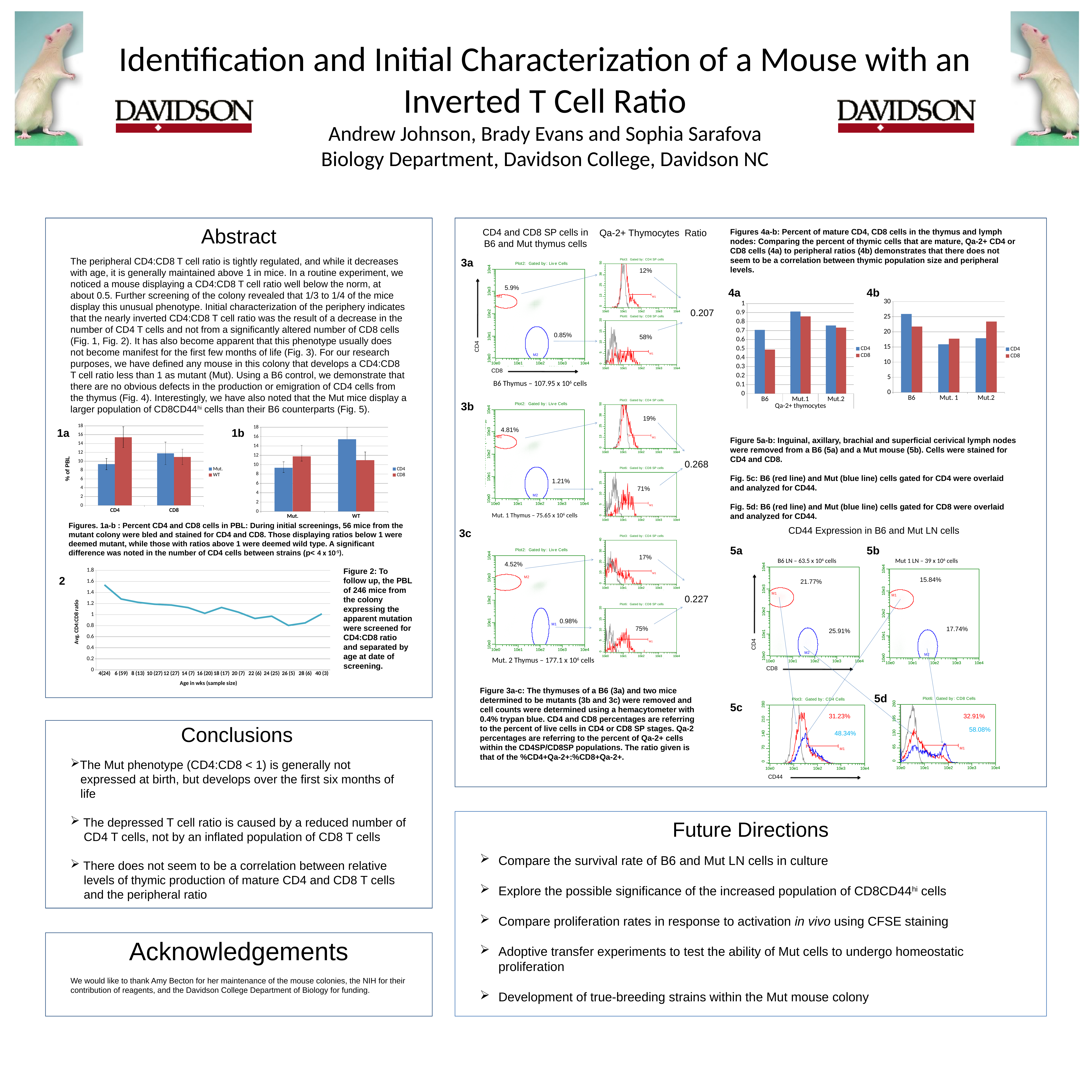
In chart 4a, which category has the highest CD4 bar? Mut.1 How many age categories are shown on the x axis of Figure 2? 14 In chart 4b, which is larger for Mut.2, CD4 or CD8? CD8 In chart 4b, which category has the highest CD4 bar? B6 In chart 4a, is the CD4 value for B6 greater or less than 0.6? greater In Figure 2, does the Avg. CD4:CD8 ratio generally rise or fall as age increases along the x axis? fall What kind of chart is Figure 2 (Avg. CD4:CD8 ratio against age in weeks)? line chart In chart 1a, is the WT value for CD4 greater or less than 14? greater How many series does the legend of chart 1a list? 2 In chart 1b, is the CD4 value for Mut. greater or less than 10? less In chart 1a, which series has the larger value for CD4, Mut. or WT? WT What kind of chart is chart 1a (the chart labelled 1a with % of PBL on the y axis)? bar chart